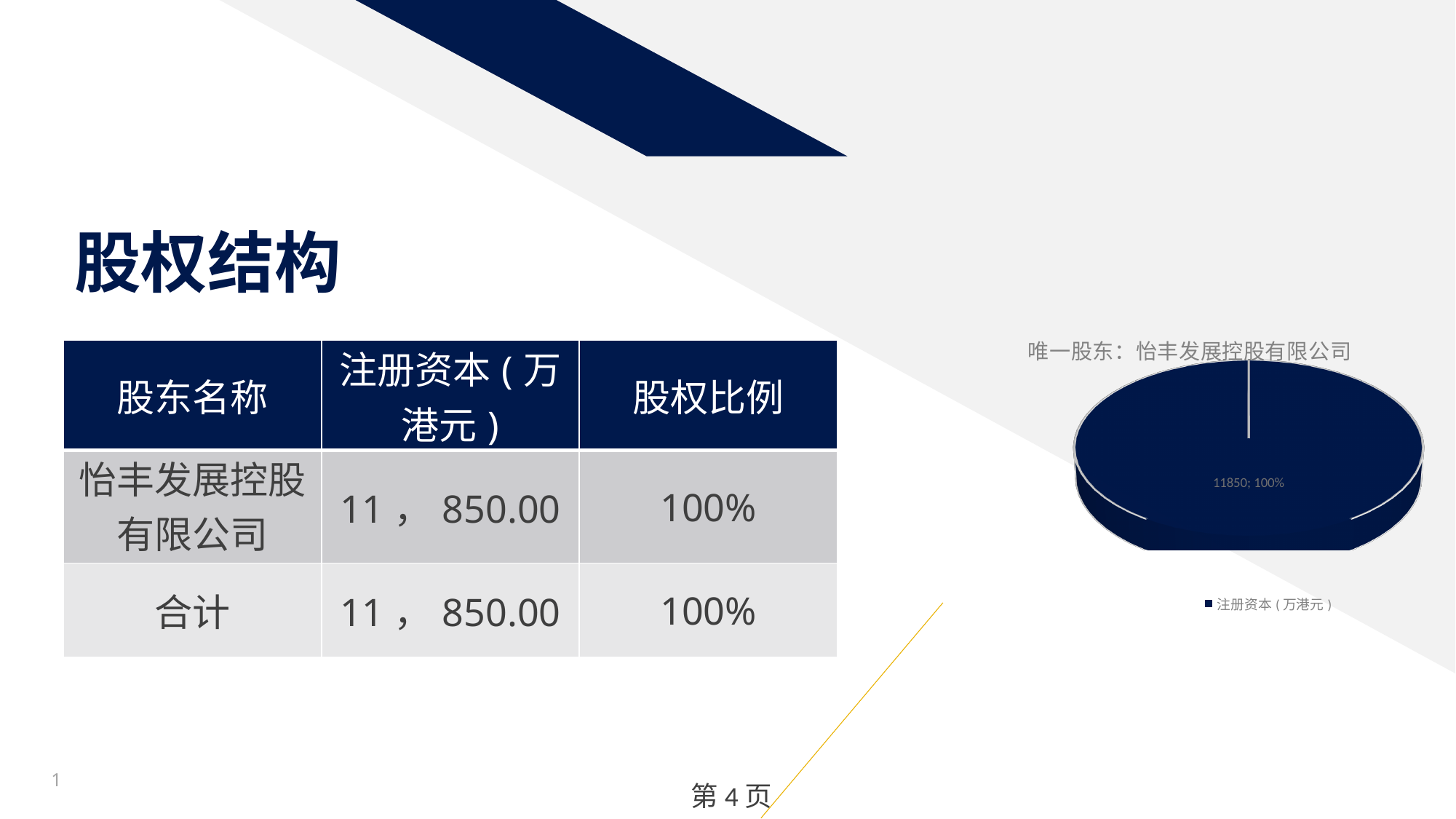
Is the value shown on the pie chart's data label greater or less than 10000? greater What kind of chart is shown on the right side of the slide? pie chart What value is printed on the data label of the pie chart's slice? 11850 What share of the pie does the single slice represent, according to its data label? 100% What entry does the pie chart's legend show? 注册资本（万港元） How many slices does the pie chart contain? 1 How many series does the pie chart's legend list? 1 What is the title of the pie chart? 唯一股东：怡丰发展控股有限公司